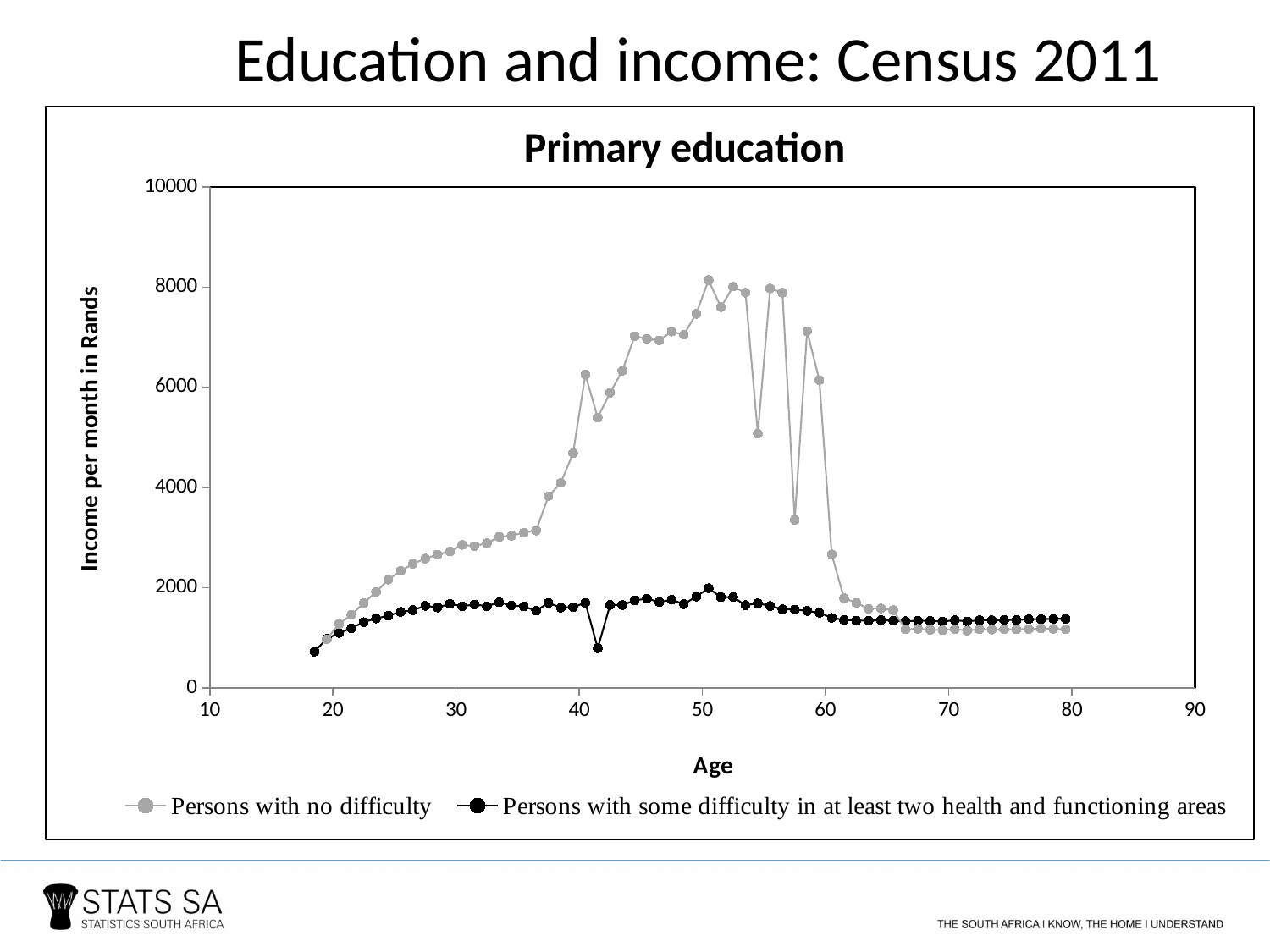
How many series does the legend list? 2 At age 50, which series has the higher income: Persons with no difficulty or Persons with some difficulty in at least two health and functioning areas? Persons with no difficulty What is the label of the vertical axis? Income per month in Rands Is the value for Persons with no difficulty at age 70 greater or less than 2000? less What is the title of the chart? Primary education Which series reaches the highest income value on the chart? Persons with no difficulty Is the value for Persons with some difficulty in at least two health and functioning areas at age 40 greater or less than 2000? less Is the value for Persons with no difficulty at age 50 greater or less than 6000? greater Between ages 60 and 65, does the income for Persons with no difficulty rise or fall? Fall What kind of chart is shown on the slide? Line chart Between ages 20 and 50, does the income for Persons with no difficulty generally rise or fall? Rise